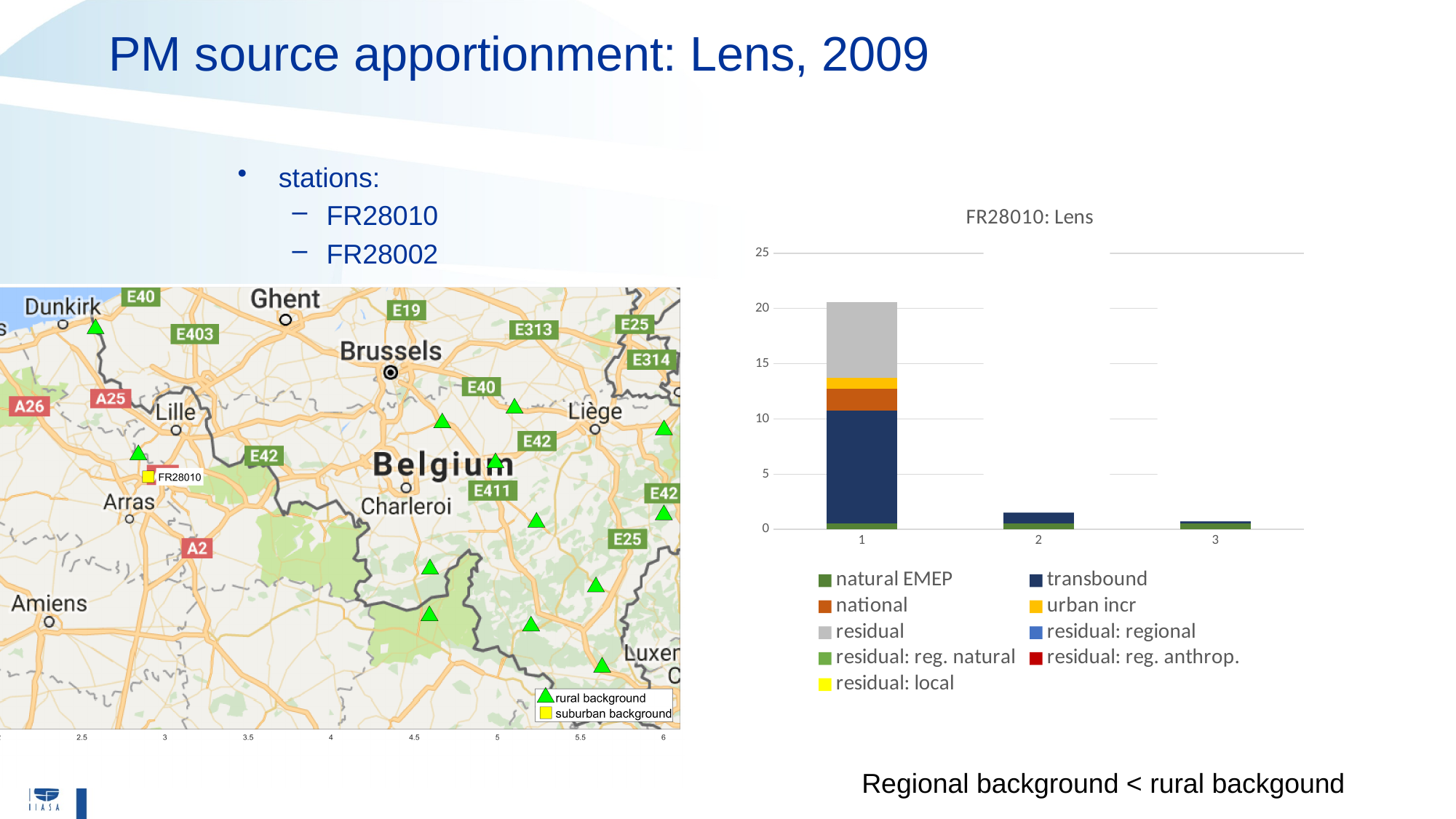
How many categories are shown on the x axis of the chart? 3 Do the stacked bar totals rise or fall from category 1 to category 3? fall Is the total height of the bar for category 1 greater or less than 20? greater Is the total height of the bar for category 2 greater or less than 5? less Is the transbound segment in the bar for category 1 greater or less than 10? greater What is the title of the chart? FR28010: Lens Which bar is taller, category 1 or category 2? 1 Which category has the shortest stacked bar? 3 Which series forms the largest segment of the bar for category 1? transbound How many series does the chart legend list? 9 What kind of chart is shown on the slide? stacked bar chart Which category has the tallest stacked bar? 1